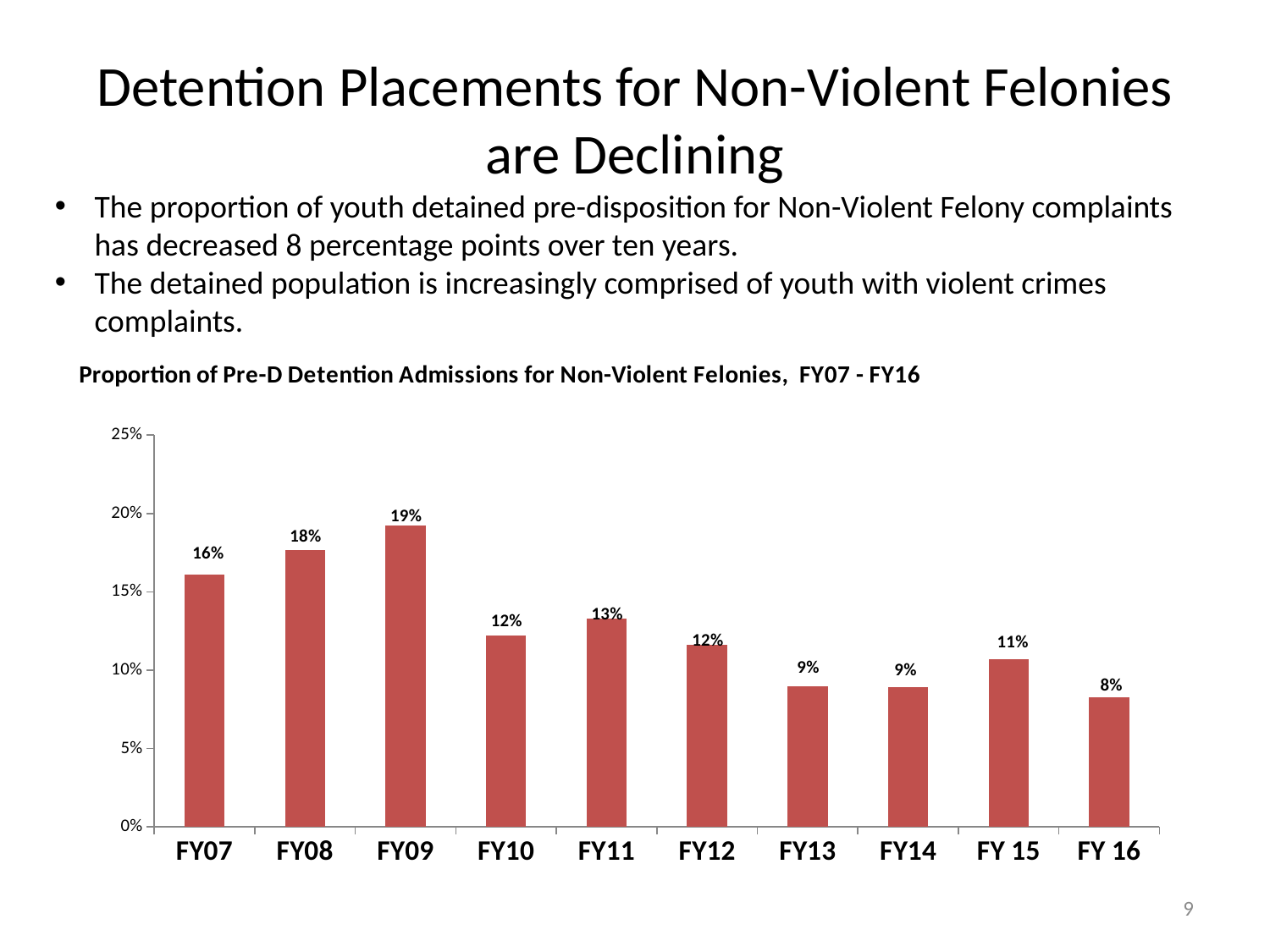
What is the value for FY09? 19% How many fiscal years are shown on the x axis? 10 Which is larger, the value for FY08 or the value for FY 15? FY08 What is the value for FY13? 9% Which fiscal year has the lowest proportion? FY 16 What kind of chart is shown on the slide? bar chart Which fiscal year has the highest proportion? FY09 What is the difference between the values for FY09 and FY 16? 11% What is the title of the chart? Proportion of Pre-D Detention Admissions for Non-Violent Felonies, FY07 - FY16 What is the value for FY 16? 8% Do the values generally rise or fall from FY07 to FY 16? fall Is the value for FY07 greater or less than 15%? greater